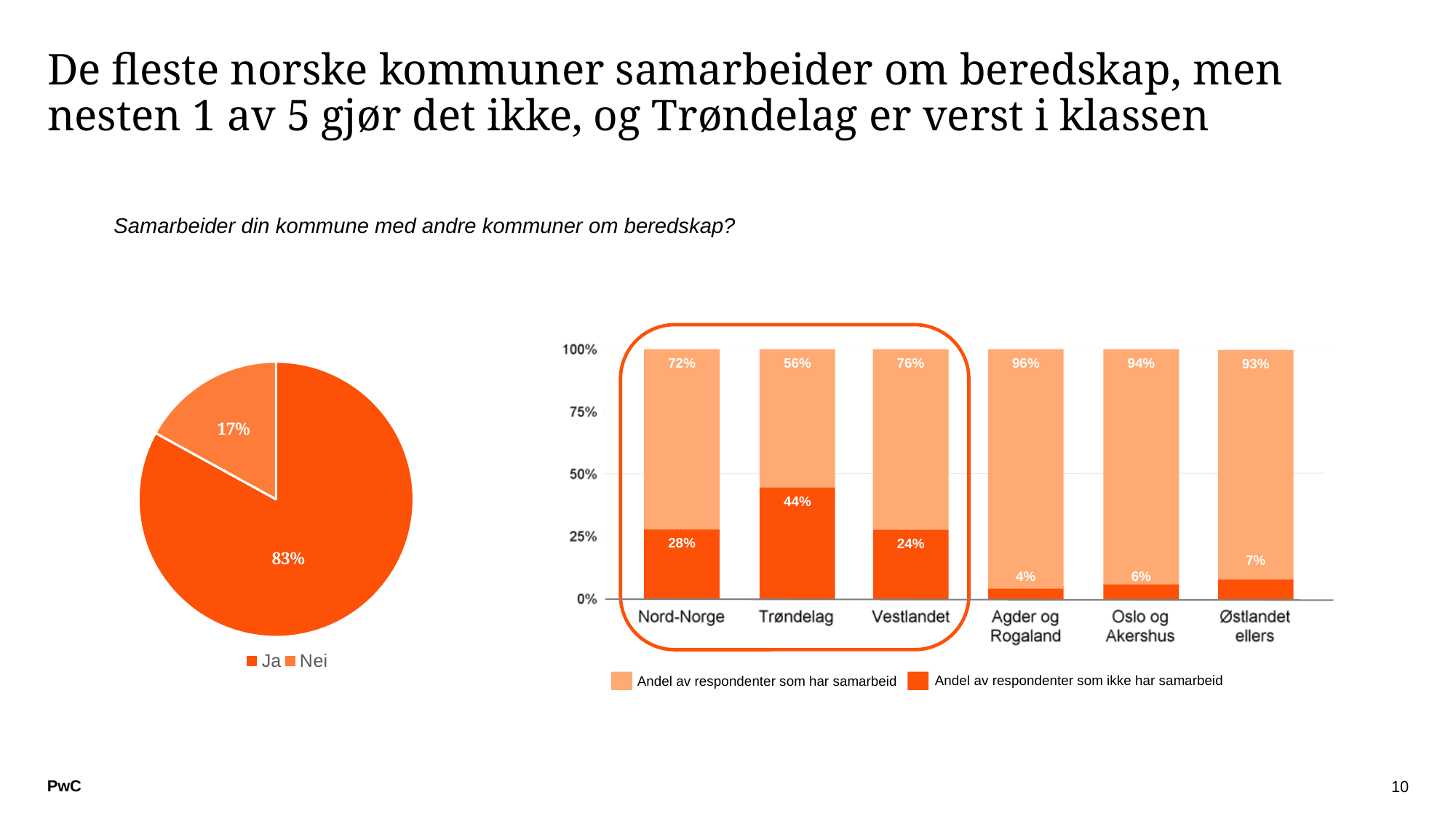
In the bar chart on the right, what is the difference between the share of respondents who have cooperation in Vestlandet and in Nord-Norge? 4 percentage points In the pie chart on the left, what share of respondents answered "Nei"? 17% In the bar chart on the right, how many regions are shown on the x axis? 6 In the pie chart on the left, what share of respondents answered "Ja"? 83% In the bar chart on the right, what is the share of respondents who do not have cooperation ("ikke har samarbeid") in Trøndelag? 44% In the bar chart on the right, which is larger: the share of respondents who do not have cooperation in Oslo og Akershus or in Østlandet ellers? Østlandet ellers In the bar chart on the right, what is the share of respondents who have cooperation ("har samarbeid") in Agder og Rogaland? 96% In the pie chart on the left, how many slices are there? 2 In the bar chart on the right, which region has the lowest share of respondents who do not have cooperation? Agder og Rogaland In the bar chart on the right, how many series does the legend list? 2 In the bar chart on the right, which region has the highest share of respondents who do not have cooperation? Trøndelag What kind of chart is the chart on the left? Pie chart